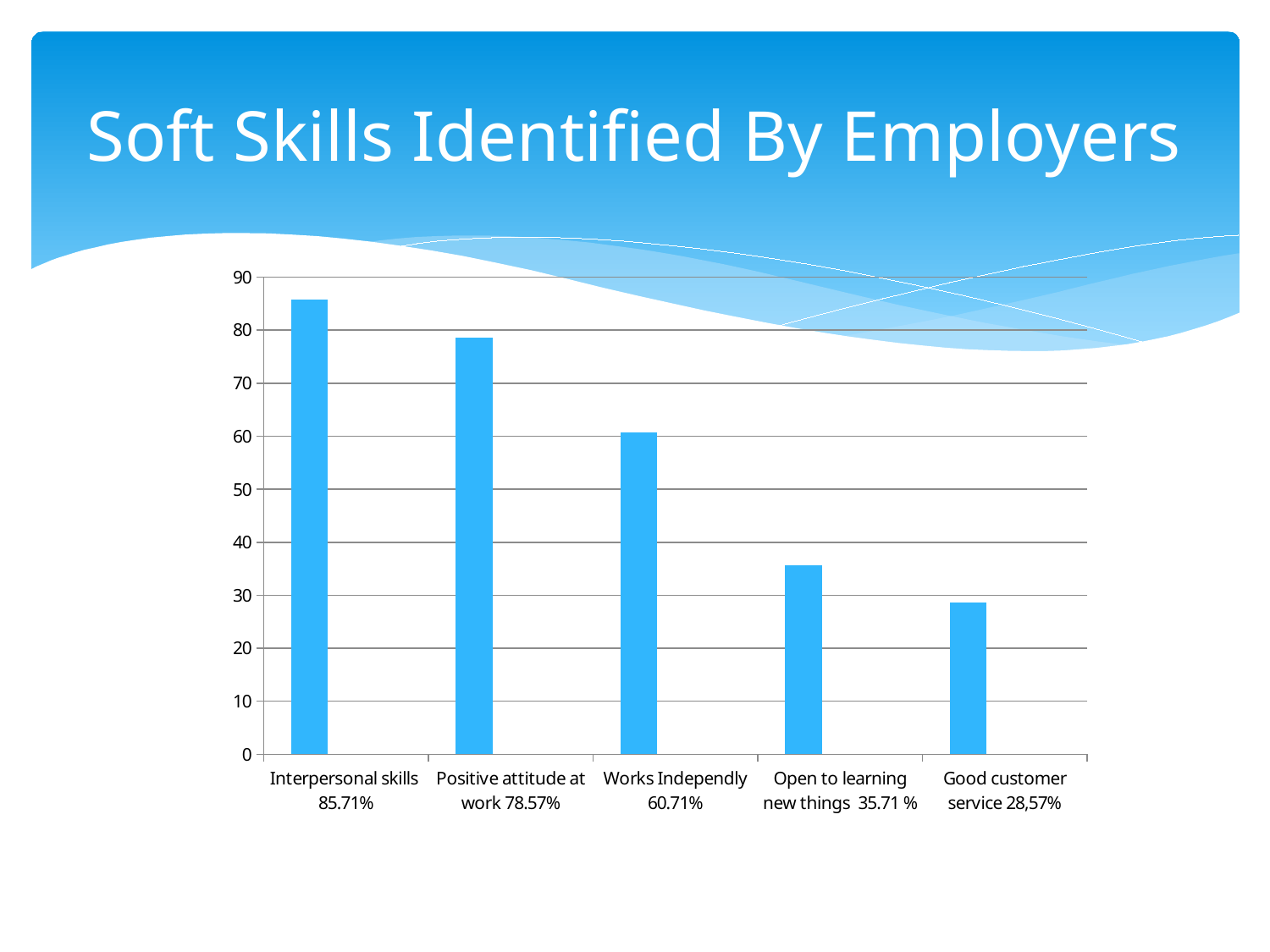
Which category has the lowest bar? Good customer service What value is printed for Open to learning new things? 35.71 % What value is printed for Works Independly? 60.71% Which is larger, the value for Works Independly or the value for Open to learning new things? Works Independly What is the title of the slide's chart? Soft Skills Identified By Employers What value is printed for Interpersonal skills? 85.71% Which category has the highest bar? Interpersonal skills What value is printed for Positive attitude at work? 78.57% How many categories are plotted in the chart? 5 Is the value for Good customer service greater or less than 30? less Do the bar values rise or fall from left to right along the x axis? fall What kind of chart is shown on the slide? bar chart